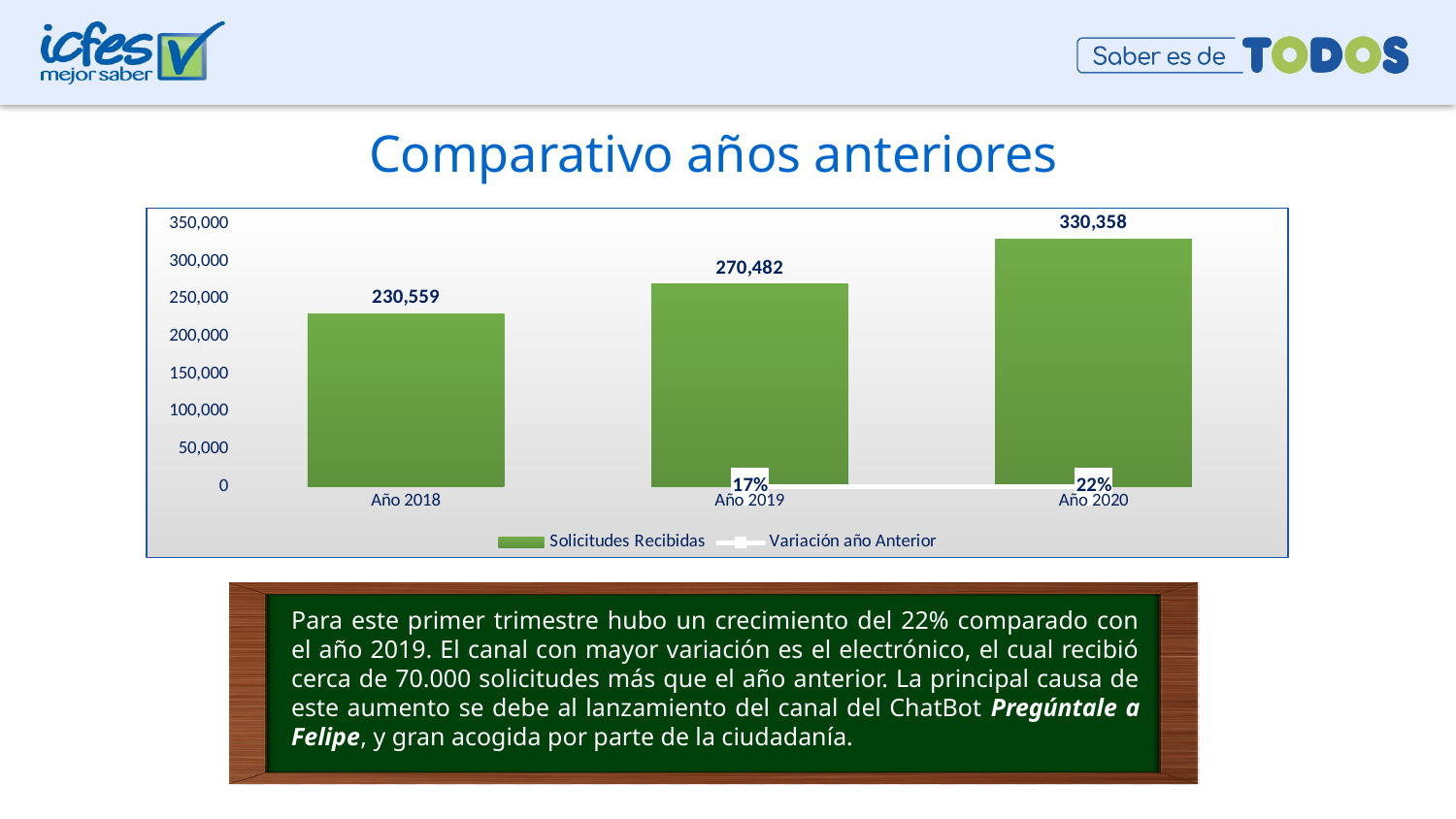
Which year has the highest number of Solicitudes Recibidas? Año 2020 What is the difference in Solicitudes Recibidas between Año 2020 and Año 2019? 59,876 What is the value of Solicitudes Recibidas for Año 2020? 330,358 Which year has the lowest number of Solicitudes Recibidas? Año 2018 Which is larger, Solicitudes Recibidas for Año 2019 or for Año 2018? Año 2019 What is the Variación año Anterior value shown for Año 2020? 22% Do the Solicitudes Recibidas values rise or fall from Año 2018 to Año 2020? rise What is the Variación año Anterior value shown for Año 2019? 17% What is the value of Solicitudes Recibidas for Año 2018? 230,559 What is the value of Solicitudes Recibidas for Año 2019? 270,482 How many years are shown on the x axis of the chart? 3 How many series does the chart legend list? 2